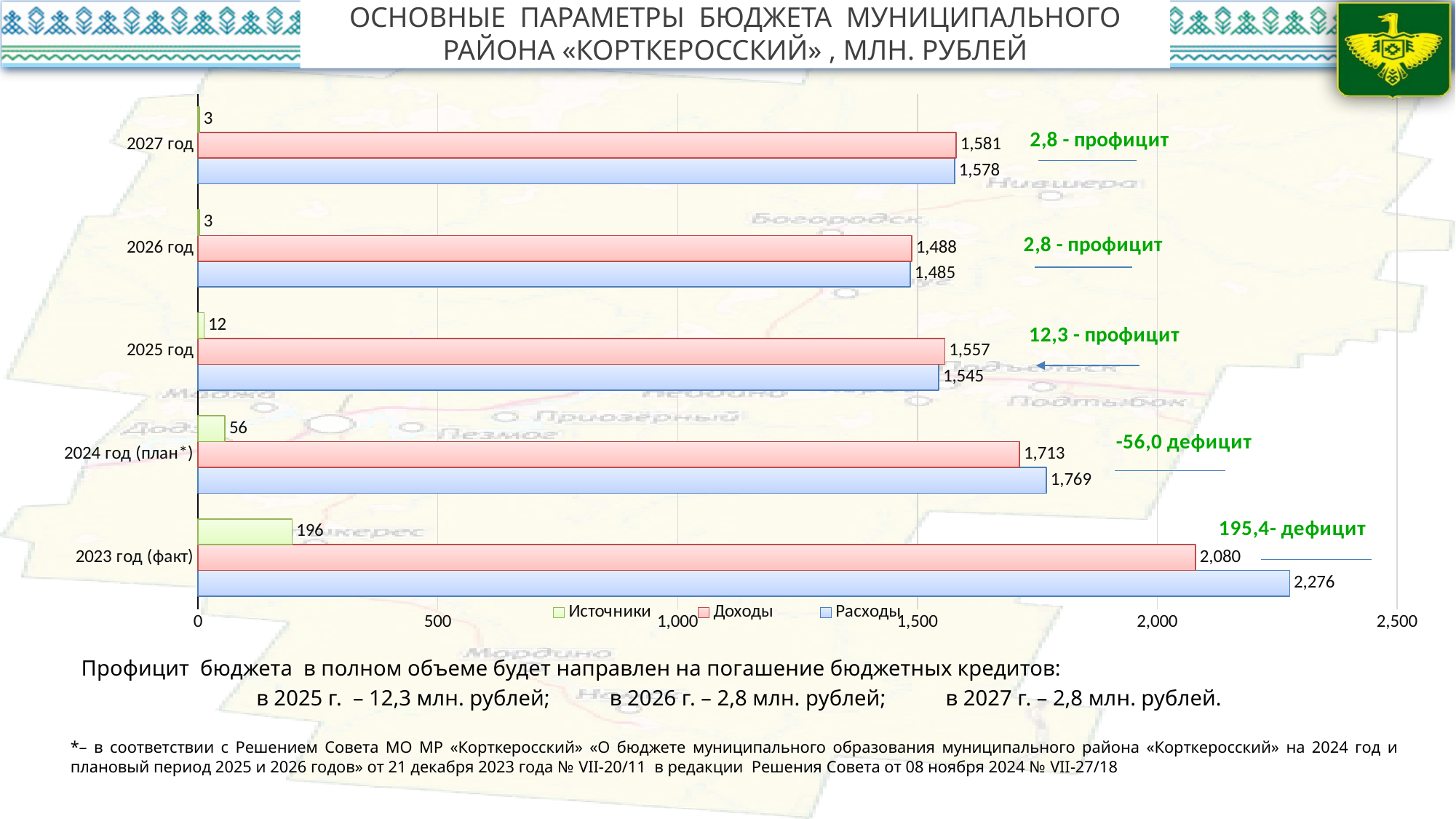
Which year has the highest Расходы value? 2023 год (факт) How many series does the legend list? 3 Which is larger for 2025 год: Доходы or Расходы? Доходы What is the difference between Расходы and Доходы for 2023 год (факт)? 196 Which year has the lowest Доходы value? 2026 год What is the value of Расходы for 2024 год (план*)? 1,769 What type of chart is shown on the slide? bar chart How many year categories are shown on the chart? 5 What is the value of Доходы for 2023 год (факт)? 2,080 What is the value of Источники for 2025 год? 12 Which series is shown in red on the chart? Доходы Is the Доходы value for 2024 год (план*) greater or less than 1,500? greater